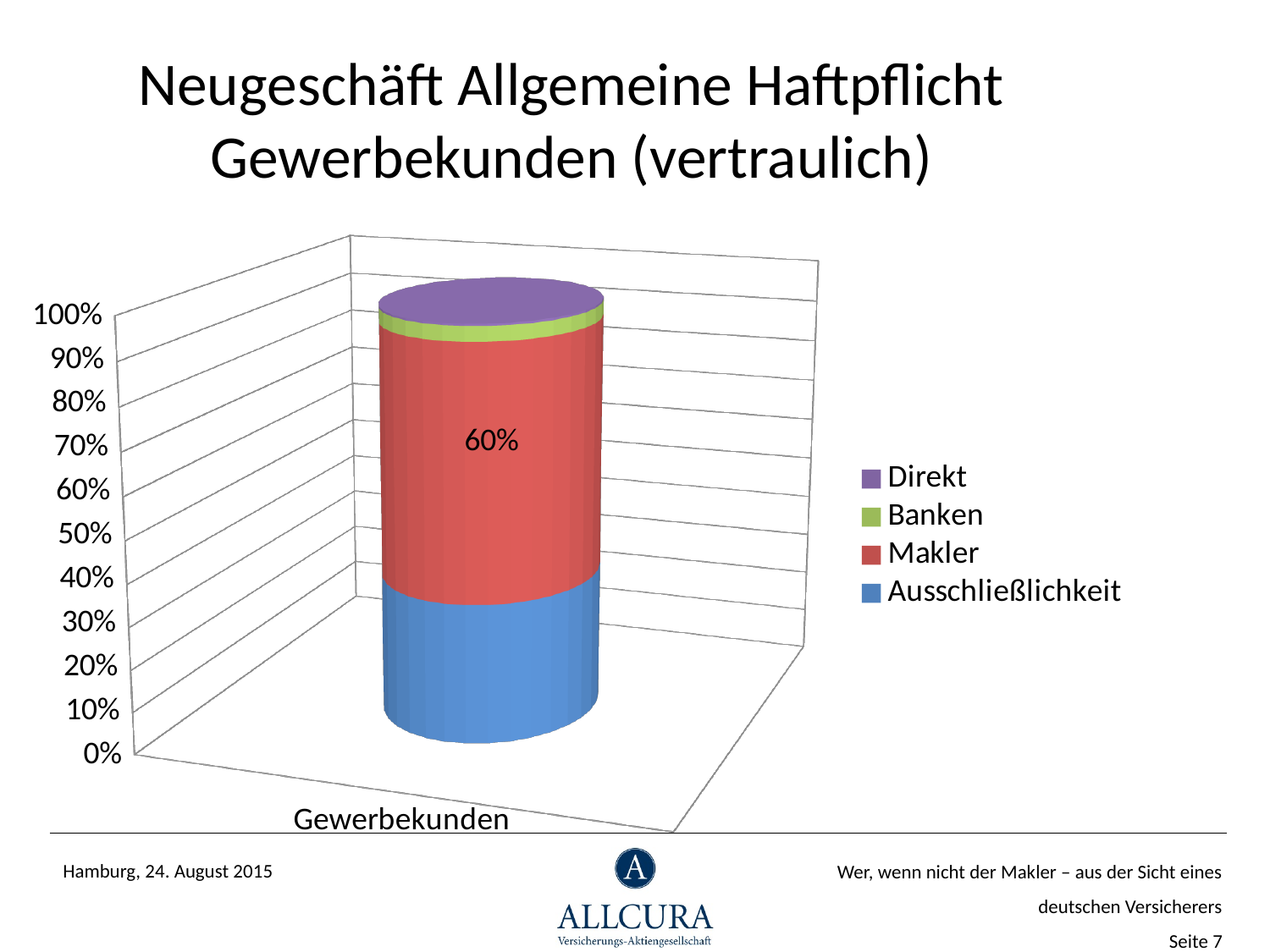
Which is larger in the Gewerbekunden bar, the Makler segment or the Ausschließlichkeit segment? Makler How many categories are plotted on the x axis? 1 Is the value for Ausschließlichkeit greater or less than 50%? less What percentage is shown for the Makler segment of the Gewerbekunden bar? 60% Which series is shown in red in the legend? Makler How many series does the legend list? 4 What is the label of the single category on the x axis? Gewerbekunden Is the value for Ausschließlichkeit greater or less than 20%? greater Is the value for Banken greater or less than 10%? less Which series makes up the largest share of the Gewerbekunden bar? Makler What kind of chart is shown on the slide? Stacked bar chart